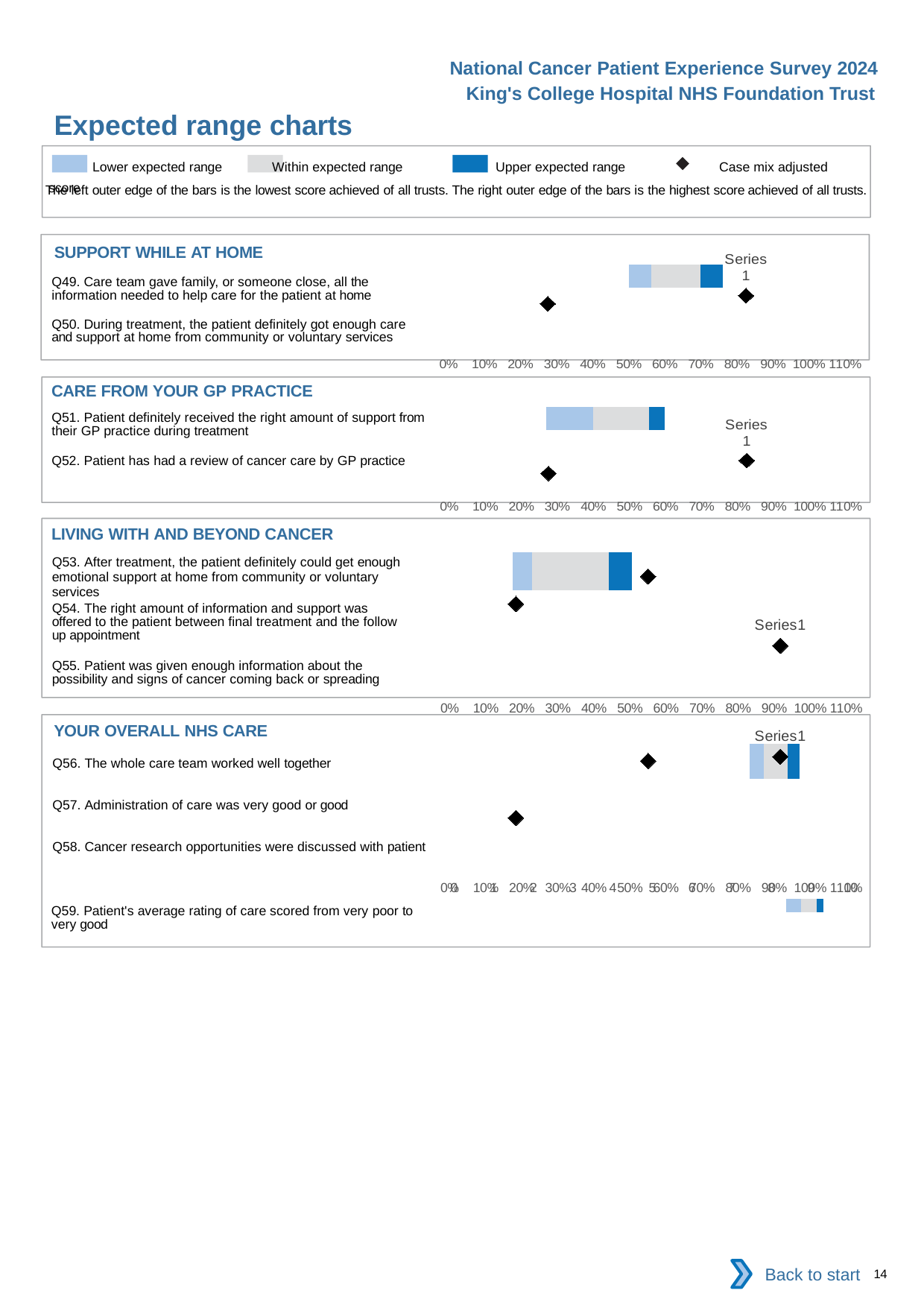
How many diamond markers are plotted in the LIVING WITH AND BEYOND CANCER chart? 3 How many entries does the legend at the top of the slide list? 4 How many questions are listed in the LIVING WITH AND BEYOND CANCER chart? 3 In the legend, what does the diamond symbol represent? Case mix adjusted score What is the highest value shown on the x axis of the CARE FROM YOUR GP PRACTICE chart? 110% How many questions are listed in the YOUR OVERALL NHS CARE chart? 4 In the CARE FROM YOUR GP PRACTICE chart, is the left edge of the expected range bar greater or less than 20%? greater What kind of chart is used in the SUPPORT WHILE AT HOME section? Bar chart In the LIVING WITH AND BEYOND CANCER chart, is the right edge of the expected range bar greater or less than 40%? greater